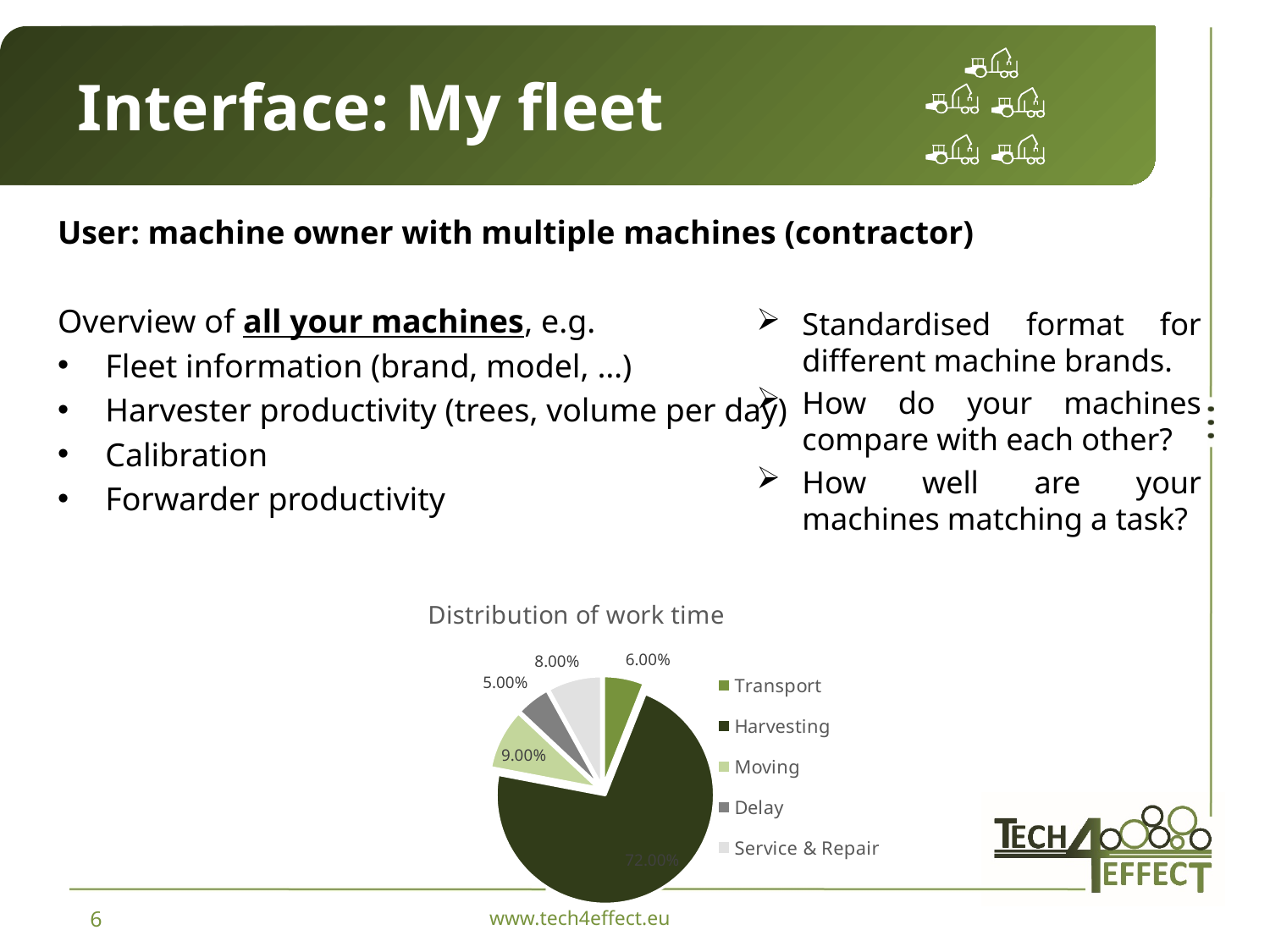
Which has a larger share of work time, Moving or Service & Repair? Moving What share of work time is Service & Repair? 8.00% What is the title of the chart? Distribution of work time Which category has the largest share of work time? Harvesting What share of work time is Moving? 9.00% What is the difference between the Harvesting share and the Moving share? 63.00% What share of work time is Harvesting? 72.00% How many categories does the legend of the pie chart list? 5 Which category has the smallest share of work time? Delay What kind of chart is shown on the slide? pie chart What share of work time is Delay? 5.00% What share of work time is Transport? 6.00%